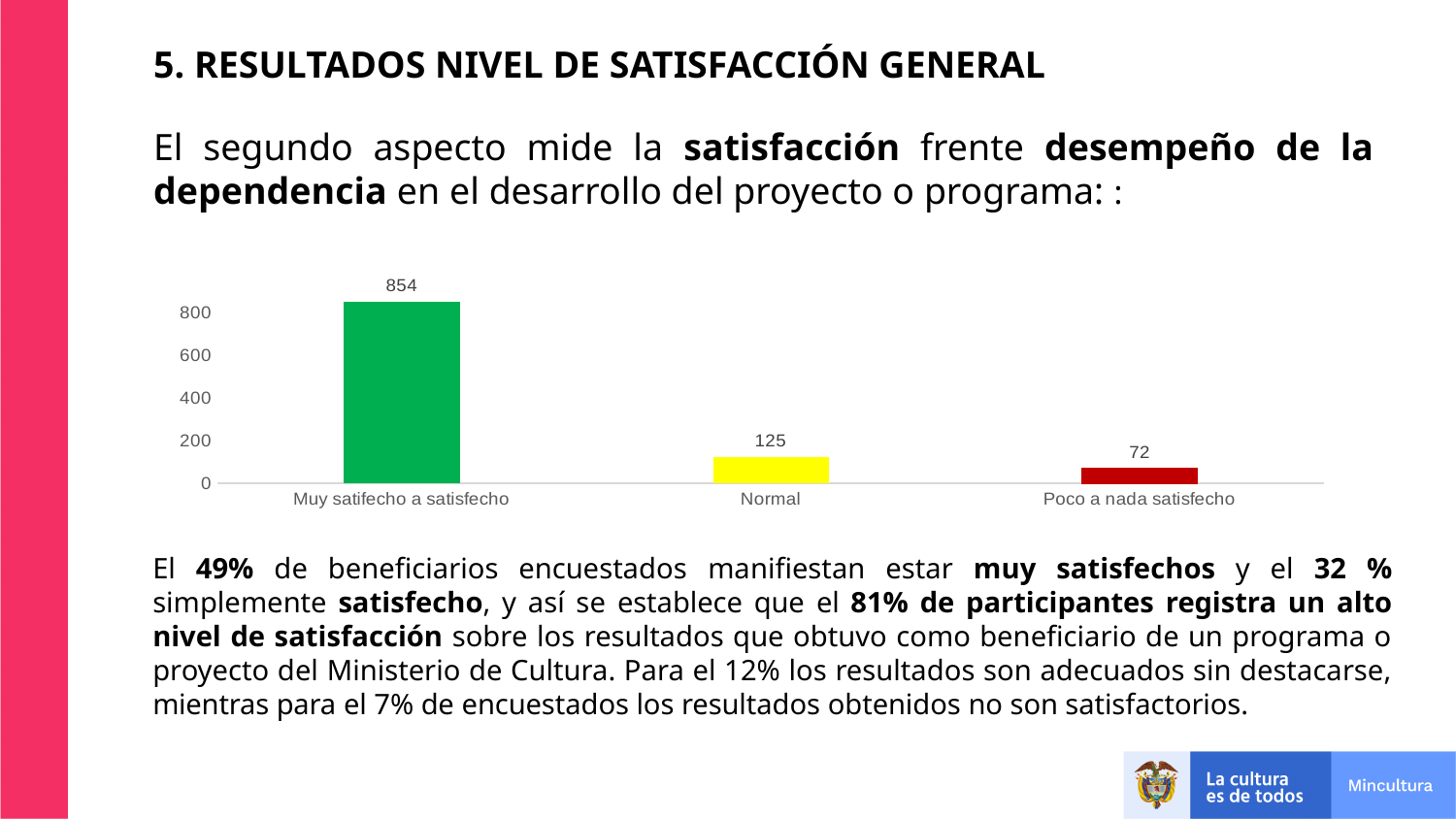
How many categories are shown on the x axis? 3 What is the value for "Muy satifecho a satisfecho"? 854 Which category has the highest value? Muy satifecho a satisfecho Is the value for "Muy satifecho a satisfecho" greater or less than 800? greater Which category has the lowest value? Poco a nada satisfecho What is the difference between the values for "Normal" and "Poco a nada satisfecho"? 53 Which is larger, the value for "Normal" or the value for "Poco a nada satisfecho"? Normal What is the value for "Normal"? 125 What colour is the bar for "Normal"? yellow What is the value for "Poco a nada satisfecho"? 72 What is the difference between the values for "Muy satifecho a satisfecho" and "Normal"? 729 What kind of chart is shown on the slide? bar chart